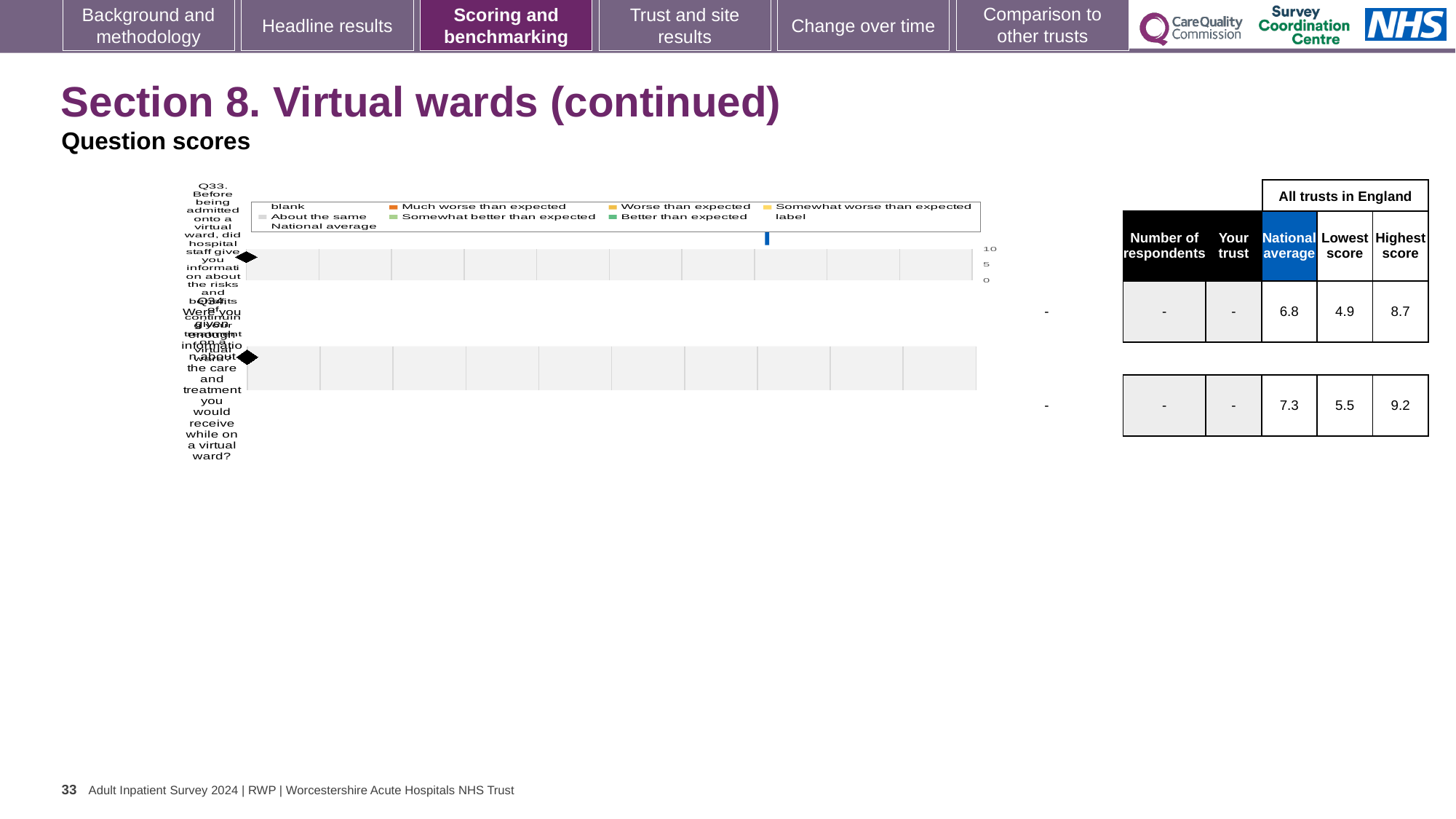
Which legend entry is shown in dark green? Better than expected In the table beside the chart, what is the lowest score for Q33? 4.9 In the table beside the chart, what is the national average score for Q34? 7.3 How many entries does the chart legend list? 9 In the table beside the chart, what is the difference between the national averages for Q34 and Q33? 0.5 In the table beside the chart, what is the national average score for Q33? 6.8 In the table beside the chart, what is the highest score for Q34? 9.2 In the table beside the chart, which question has the higher national average, Q33 or Q34? Q34 In the table beside the chart, what is the difference between the highest and lowest scores for Q33? 3.8 Which legend entry is shown in orange? Much worse than expected How many questions (categories) are plotted in the chart? 2 What kind of chart is shown on the slide? bar chart